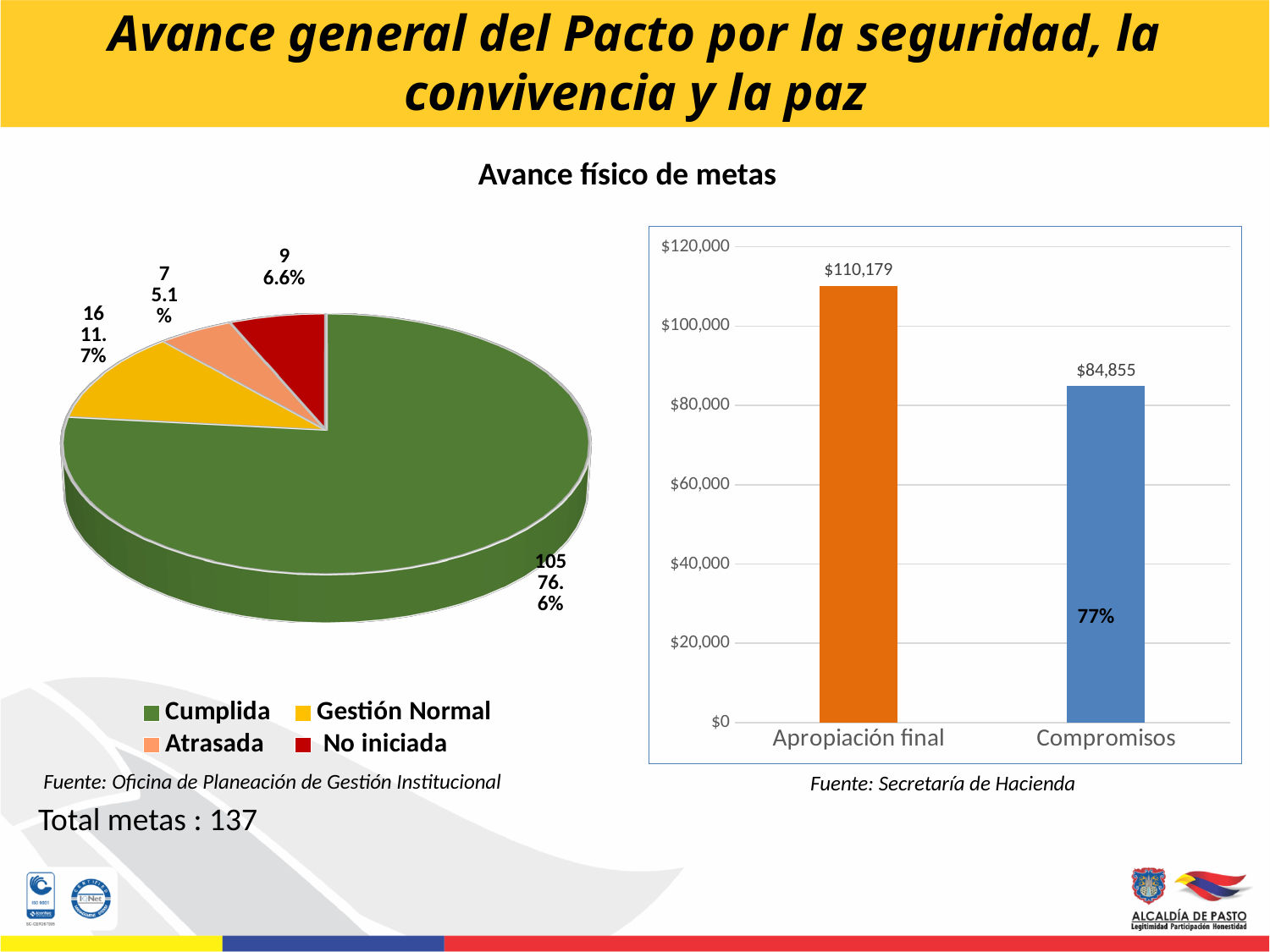
In the pie chart on the left, how many categories does the legend list? 4 In the pie chart on the left, which category has the smallest slice? Atrasada In the pie chart on the left, what is the difference between the number of Gestión Normal metas and the number of Atrasada metas? 9 In the pie chart on the left, what percentage share does the Cumplida slice have? 76.6% In the pie chart on the left, how many metas are labelled Cumplida? 105 In the bar chart on the right, what is the value for Compromisos? $84,855 In the pie chart on the left, which category has the largest slice? Cumplida In the pie chart on the left, what percentage share does the No iniciada slice have? 6.6% In the bar chart on the right, what is the difference between Apropiación final and Compromisos? $25,324 What kind of chart is shown on the right side of the slide? Bar chart In the bar chart on the right, what is the value for Apropiación final? $110,179 In the pie chart on the left, how many metas are in Gestión Normal? 16